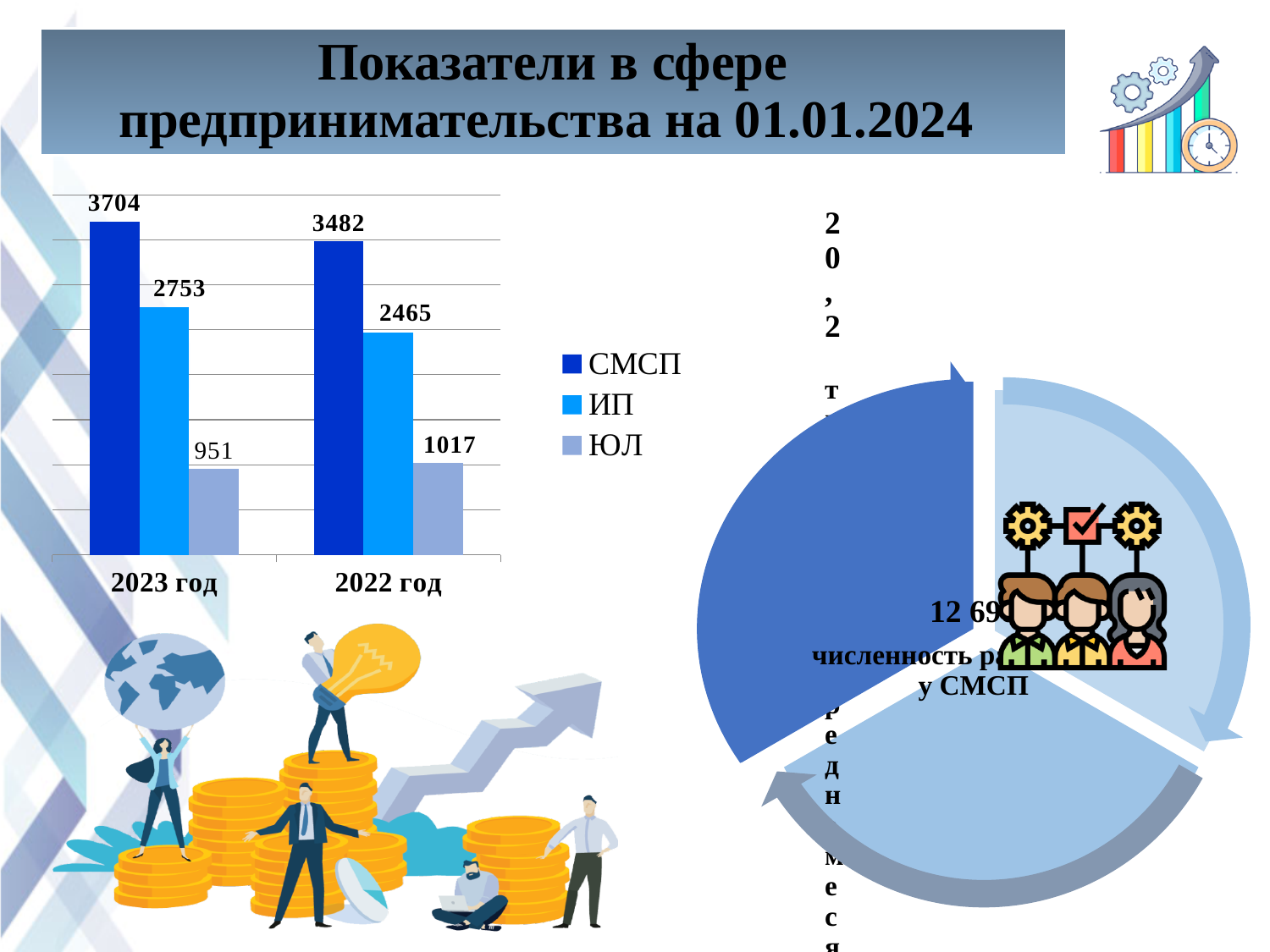
What kind of chart is shown on the left of the slide? bar chart How many categories are shown on the x axis of the bar chart? 2 On the bar chart, what is the difference between the СМСП values for 2023 год and 2022 год? 222 On the bar chart, what is the value for ЮЛ in 2023 год? 951 On the bar chart, what is the difference between the ИП values for 2023 год and 2022 год? 288 On the bar chart, which is larger: ЮЛ in 2023 год or ЮЛ in 2022 год? ЮЛ in 2022 год On the bar chart, what is the value for ЮЛ in 2022 год? 1017 On the bar chart, what is the value for СМСП in 2023 год? 3704 On the bar chart, which series has the highest value in 2023 год? СМСП On the bar chart, what is the value for ИП in 2022 год? 2465 On the bar chart, which series has the lowest value in 2022 год? ЮЛ How many series does the legend of the bar chart list? 3